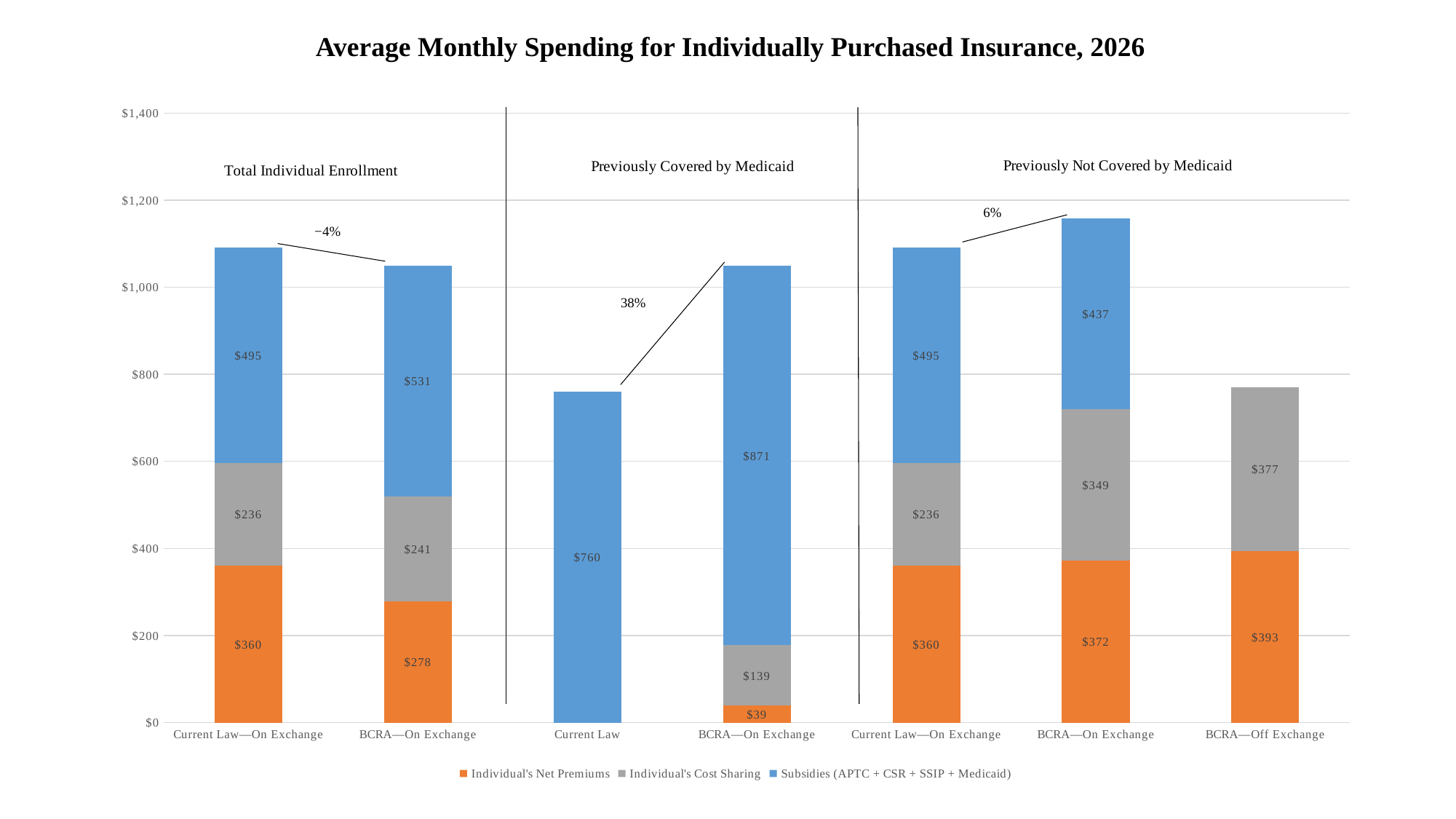
In the Previously Not Covered by Medicaid panel, what is the Individual's Cost Sharing value for BCRA—On Exchange? $349 How many series does the legend list? 3 What kind of chart is shown on the slide? Stacked bar chart In the Previously Covered by Medicaid panel, what is the Subsidies value for Current Law? $760 What percentage change is labelled in the Previously Covered by Medicaid panel? 38% What is the total of the BCRA—Off Exchange bar in the Previously Not Covered by Medicaid panel? $770 In the Total Individual Enrollment panel, what is the difference between the Subsidies values for BCRA—On Exchange and Current Law—On Exchange? $36 In the Previously Not Covered by Medicaid panel, which has the larger Individual's Net Premiums value: Current Law—On Exchange or BCRA—On Exchange? BCRA—On Exchange How many bars are plotted on the chart in total? 7 Which bar has the largest Subsidies segment? BCRA—On Exchange in the Previously Covered by Medicaid panel In the Previously Not Covered by Medicaid panel, what is the Individual's Cost Sharing value for BCRA—Off Exchange? $377 In the Previously Covered by Medicaid panel, what is the Individual's Net Premiums value for BCRA—On Exchange? $39